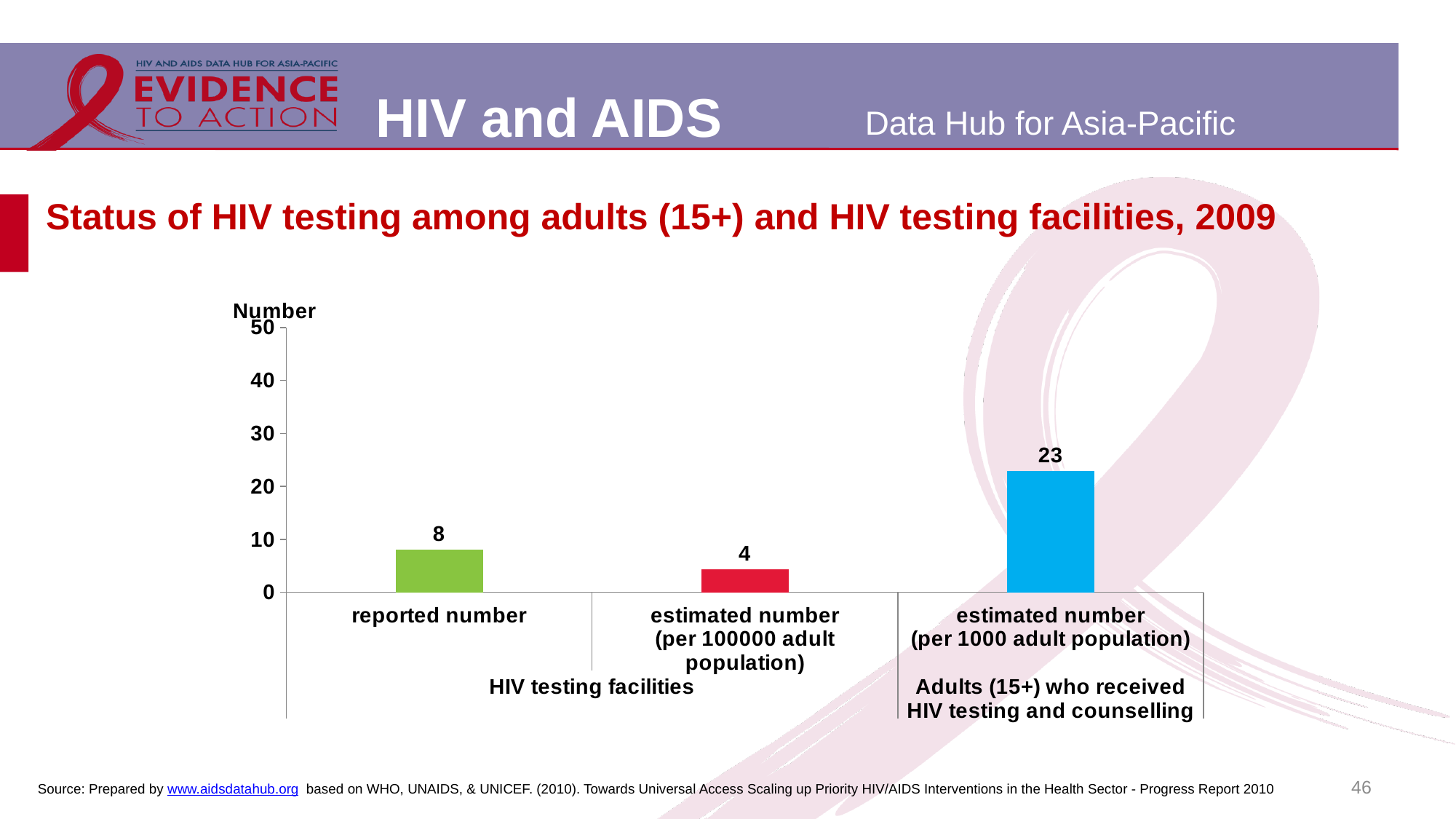
How many bars are shown in the chart? 3 Is the value for adults (15+) who received HIV testing and counselling greater or less than 20? greater Which category has the highest value? estimated number (per 1000 adult population) of adults (15+) who received HIV testing and counselling What is the difference between the value for adults who received HIV testing and counselling and the reported number of HIV testing facilities? 15 Which is larger: the reported number of HIV testing facilities or the estimated number per 100000 adult population? reported number What is the difference between the reported number of HIV testing facilities and the estimated number per 100000 adult population? 4 What is the estimated number of adults (15+) who received HIV testing and counselling per 1000 adult population? 23 Which category has the lowest value? estimated number (per 100000 adult population) of HIV testing facilities What is the estimated number of HIV testing facilities per 100000 adult population? 4 What is the label of the vertical axis? Number What is the reported number of HIV testing facilities? 8 What type of chart is shown on the slide? bar chart